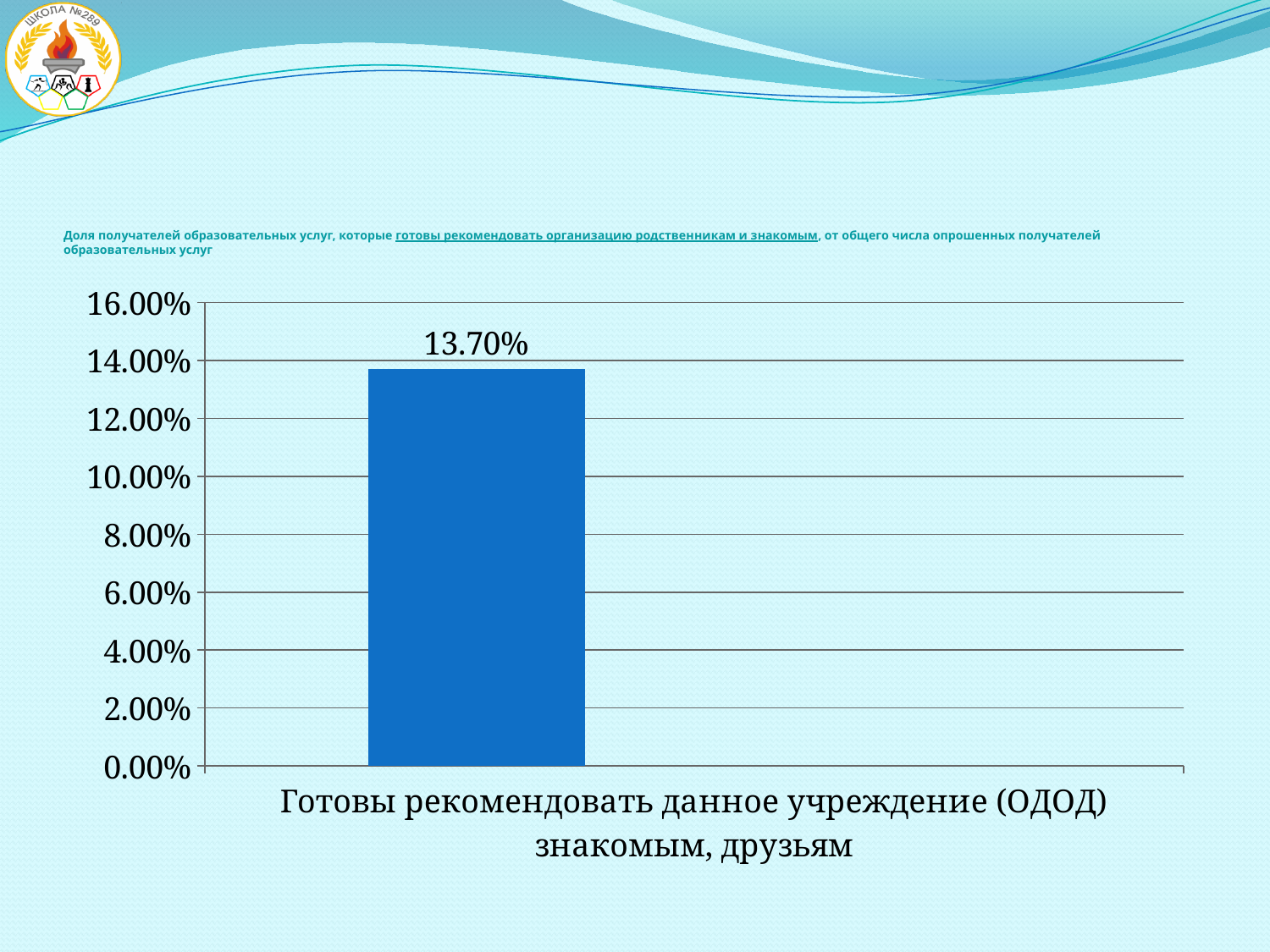
Is the value for "Готовы рекомендовать данное учреждение (ОДОД) знакомым, друзьям" greater or less than 14.00%? less Is the value for "Готовы рекомендовать данное учреждение (ОДОД) знакомым, друзьям" greater or less than 12.00%? greater What is the value shown for "Готовы рекомендовать данное учреждение (ОДОД) знакомым, друзьям"? 13.70% What is the category label shown under the bar? Готовы рекомендовать данное учреждение (ОДОД) знакомым, друзьям How many bars are plotted in the chart? 1 What kind of chart is shown on the slide? bar chart What is the highest value shown on the vertical axis? 16.00%